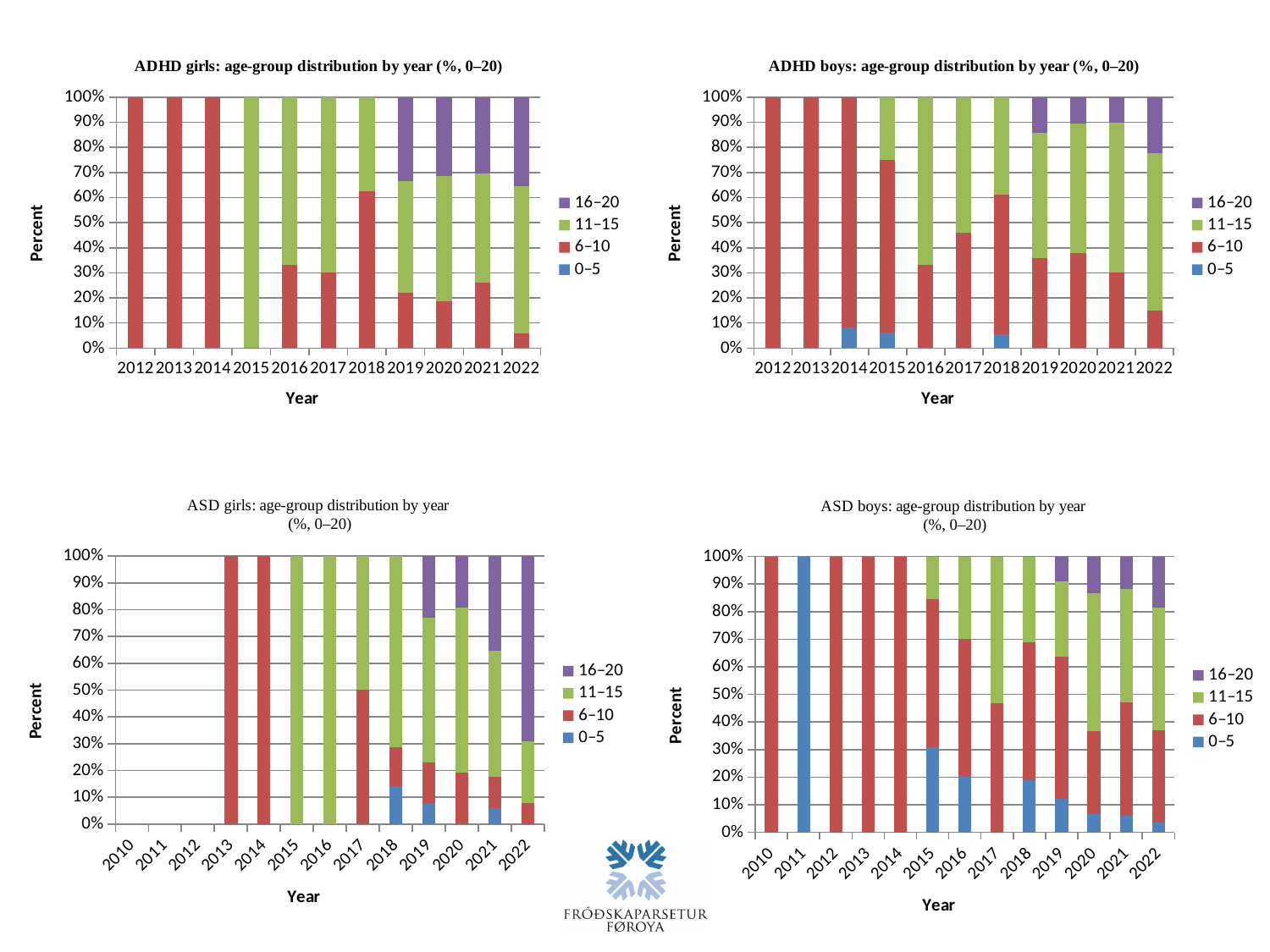
In the 'ASD boys' chart, which age group makes up the entire bar for 2011? 0–5 In the 'ADHD boys' chart, is the 6–10 share larger in 2018 or in 2019? 2018 In the 'ASD boys' chart, is the 6–10 share in 2012 greater or less than 90%? greater In the 'ADHD boys' chart, is the 6–10 share in 2022 greater or less than 20%? less How many series does the legend of the 'ADHD boys' chart list? 4 In the 'ADHD girls' chart, which age group makes up the entire bar for 2015? 11–15 In the 'ADHD girls' chart, in which year does the 16–20 age group first appear? 2019 In the 'ASD girls' chart, what is the first year with a bar plotted? 2013 What kind of chart is the 'ADHD girls: age-group distribution by year' chart? stacked bar chart In the 'ASD boys' chart, is the 0–5 share in 2015 greater or less than 20%? greater How many years are shown on the x axis of the 'ASD girls' chart? 13 How many years are shown on the x axis of the 'ADHD girls' chart? 11